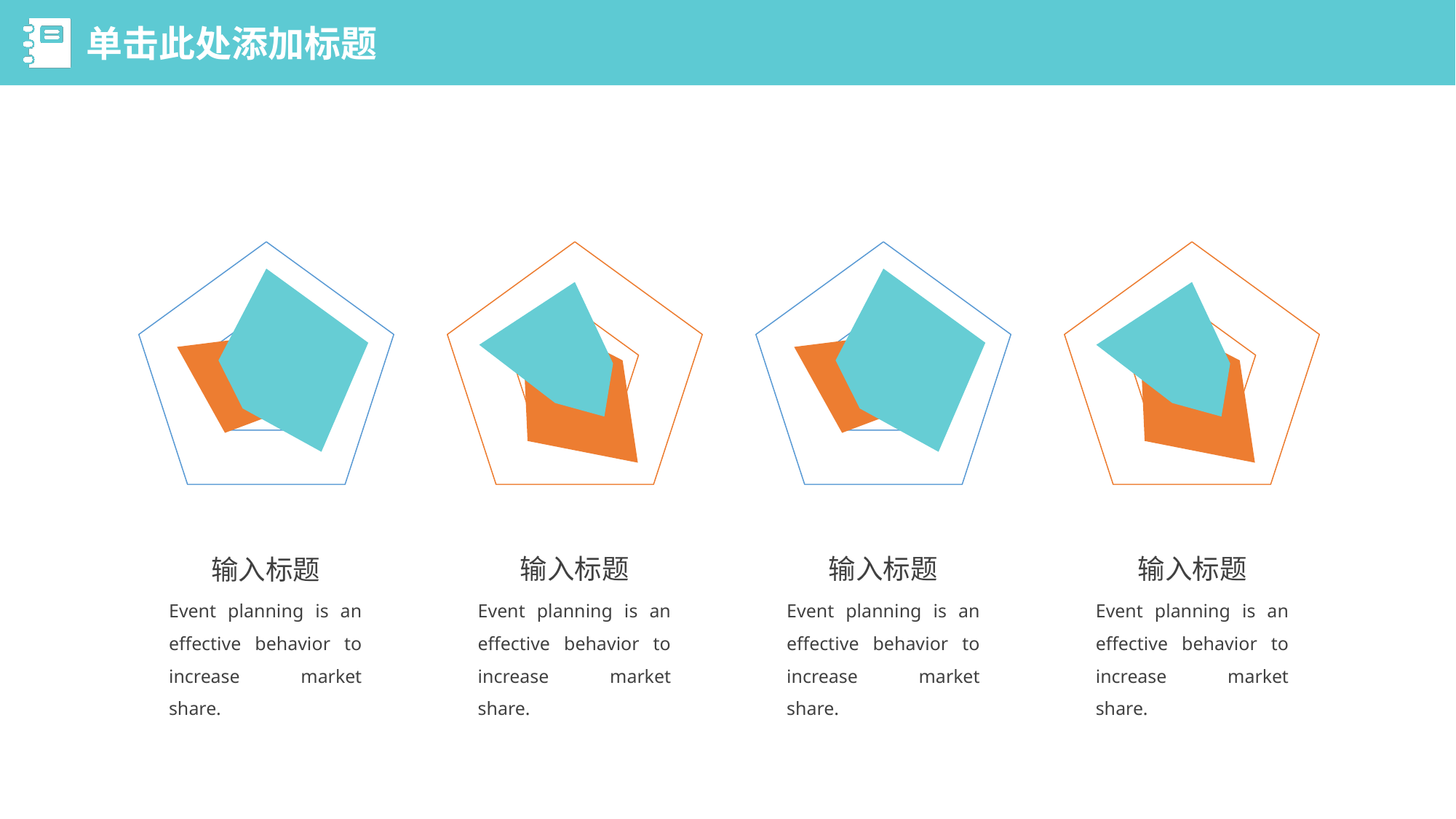
How many radar charts are on the slide? 4 What two colours are used for the filled series in the rightmost chart? teal and orange How many axes does the rightmost radar chart have? 5 What kind of chart is shown in the leftmost chart on the slide? radar chart What colour is the outer pentagon outline of the second chart from the left? orange How many filled series are plotted in the second chart from the left? 2 In the leftmost chart, which filled series covers the larger area, the teal one or the orange one? teal How many axes (categories) does the leftmost radar chart have? 5